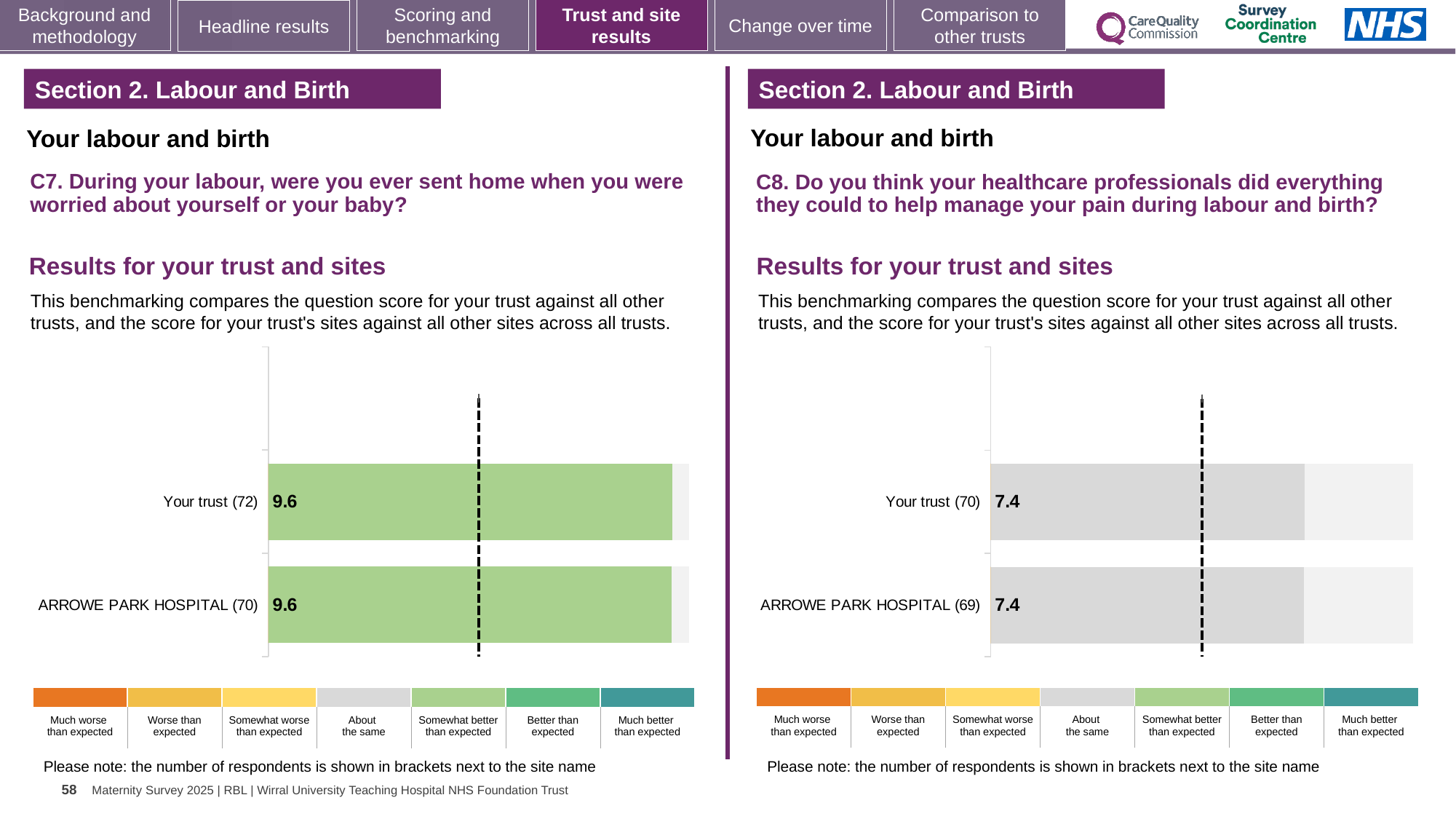
In the C8 chart on the right, what is the score for Your trust? 7.4 In the C7 chart on the left, what is the score for ARROWE PARK HOSPITAL? 9.6 In the C7 chart on the left, what is the difference between the Your trust score and the ARROWE PARK HOSPITAL score? 0 How many bars are plotted in the C7 chart on the left? 2 In the C7 chart on the left, which benchmark category does the green bar colour correspond to according to the legend? Somewhat better than expected What kind of chart is used for the C7 results on the left? Bar chart How many respondents are shown in brackets for Your trust in the C8 chart on the right? 70 In the C8 chart on the right, what is the difference between the Your trust score and the ARROWE PARK HOSPITAL score? 0 How many bars are plotted in the C8 chart on the right? 2 In the C8 chart on the right, what is the score for ARROWE PARK HOSPITAL? 7.4 In the C7 chart on the left, what is the score for Your trust? 9.6 In the C8 chart on the right, which benchmark category does the grey bar colour correspond to according to the legend? About the same